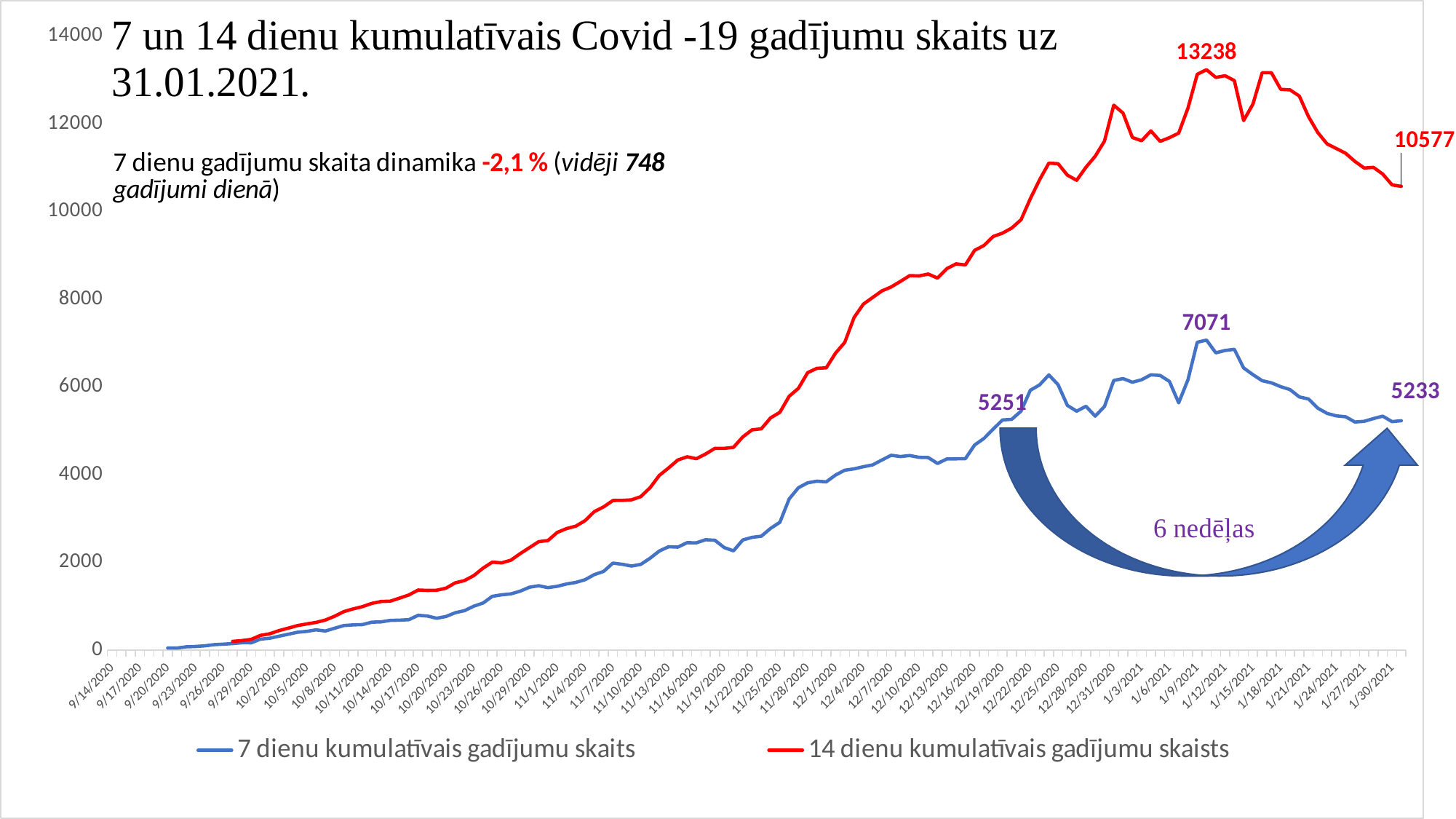
Is the value of the 14 dienu series at 12/4/2020 greater or less than 6000? greater How many series does the legend list? 2 Which series has the higher labeled peak, the 7 dienu or the 14 dienu kumulatīvais gadījumu skaits? 14 dienu kumulatīvais gadījumu skaits Is the value of the 7 dienu series at 11/1/2020 greater or less than 2000? less What is the peak value labeled on the 7 dienu kumulatīvais gadījumu skaits series? 7071 What is the final labeled value of the 7 dienu kumulatīvais gadījumu skaits series at the right end of the chart? 5233 What is the final labeled value of the 14 dienu kumulatīvais gadījumu skaits series at the right end of the chart? 10577 What value is labeled on the 7 dienu series at the start of the '6 nedēļas' arrow? 5251 What kind of chart is shown on the slide? line chart What is the difference between the labeled peak (7071) and the final labeled value (5233) of the 7 dienu series? 1838 What is the peak value labeled on the 14 dienu kumulatīvais gadījumu skaits series? 13238 What is the difference between the labeled peak (13238) and the final labeled value (10577) of the 14 dienu series? 2661